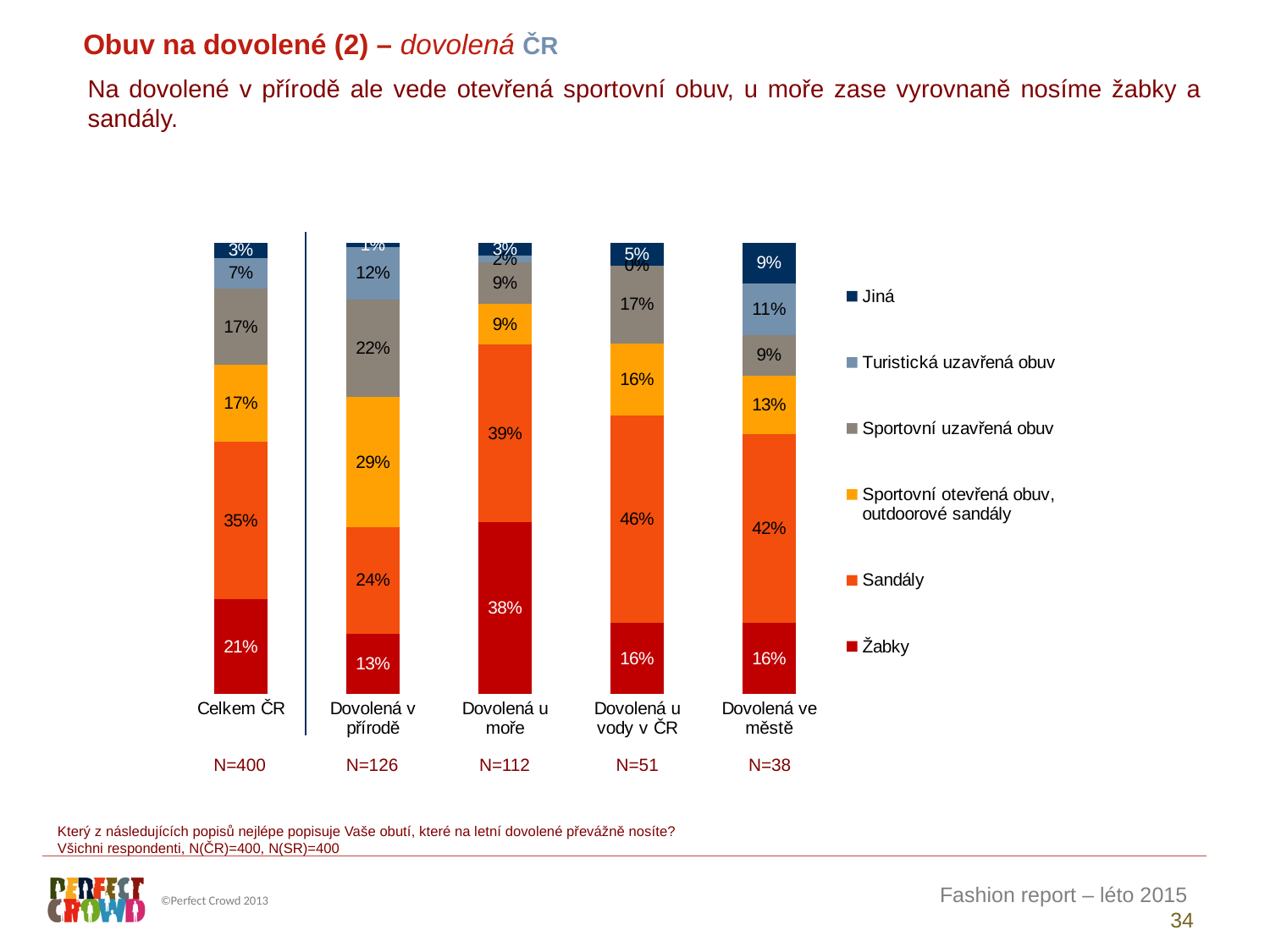
How many categories are shown on the x axis? 5 What is the value for Sandály in the Dovolená u vody v ČR category? 46% How many series does the legend list? 6 What is the value for Jiná in the Dovolená ve městě category? 9% Which category has the lowest value for Sandály? Dovolená v přírodě Which category has the highest value for Žabky? Dovolená u moře What type of chart is shown on the slide? Stacked bar chart What is the sample size (N) shown under the Dovolená u moře category? N=112 What is the difference between the Sandály value for Dovolená u vody v ČR and for Celkem ČR? 11% What is the value for Žabky in the Dovolená u moře category? 38% What is the value for Sportovní otevřená obuv, outdoorové sandály in the Dovolená v přírodě category? 29% Which is larger: the Sportovní uzavřená obuv value for Dovolená v přírodě or for Dovolená ve městě? Dovolená v přírodě